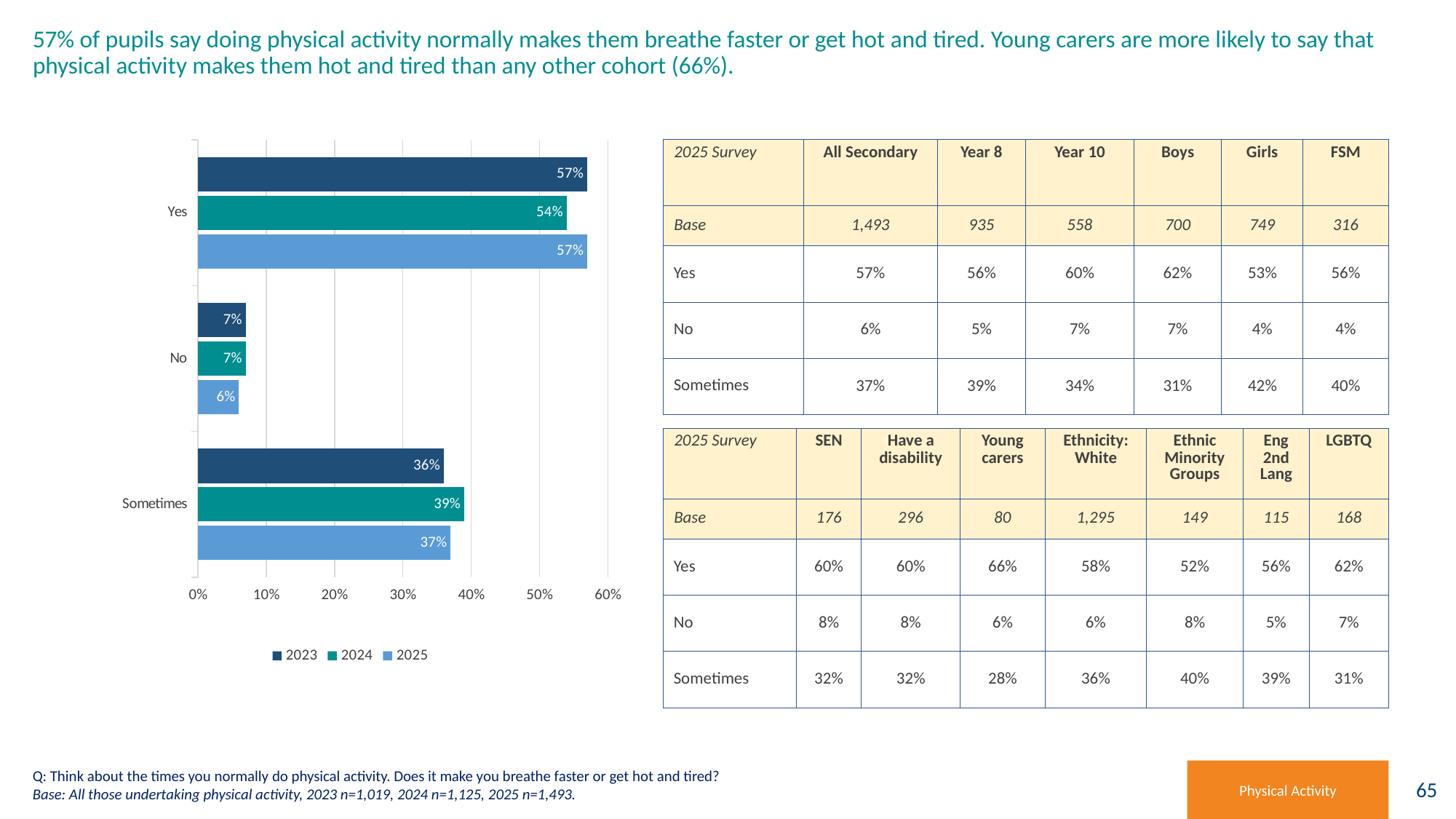
How many response categories are shown on the bar chart? 3 What type of chart is shown on the left of the slide? bar chart What percentage of pupils answered 'No' in 2025 according to the bar chart? 6% Which response category has the highest value for 2023 in the bar chart? Yes What is the difference between the 2025 and 2024 values for 'Yes' in the bar chart? 3 percentage points In the bar chart, is the 2024 value for 'Sometimes' larger or smaller than the 2023 value for 'Sometimes'? larger What percentage of pupils answered 'Yes' in 2025 according to the bar chart? 57% What percentage of pupils answered 'Sometimes' in 2024 according to the bar chart? 39% Which years are listed in the legend of the bar chart? 2023, 2024, 2025 How many series does the legend of the bar chart list? 3 Which response category has the lowest value for 2024 in the bar chart? No What is the difference between the 2023 and 2025 values for 'No' in the bar chart? 1 percentage point